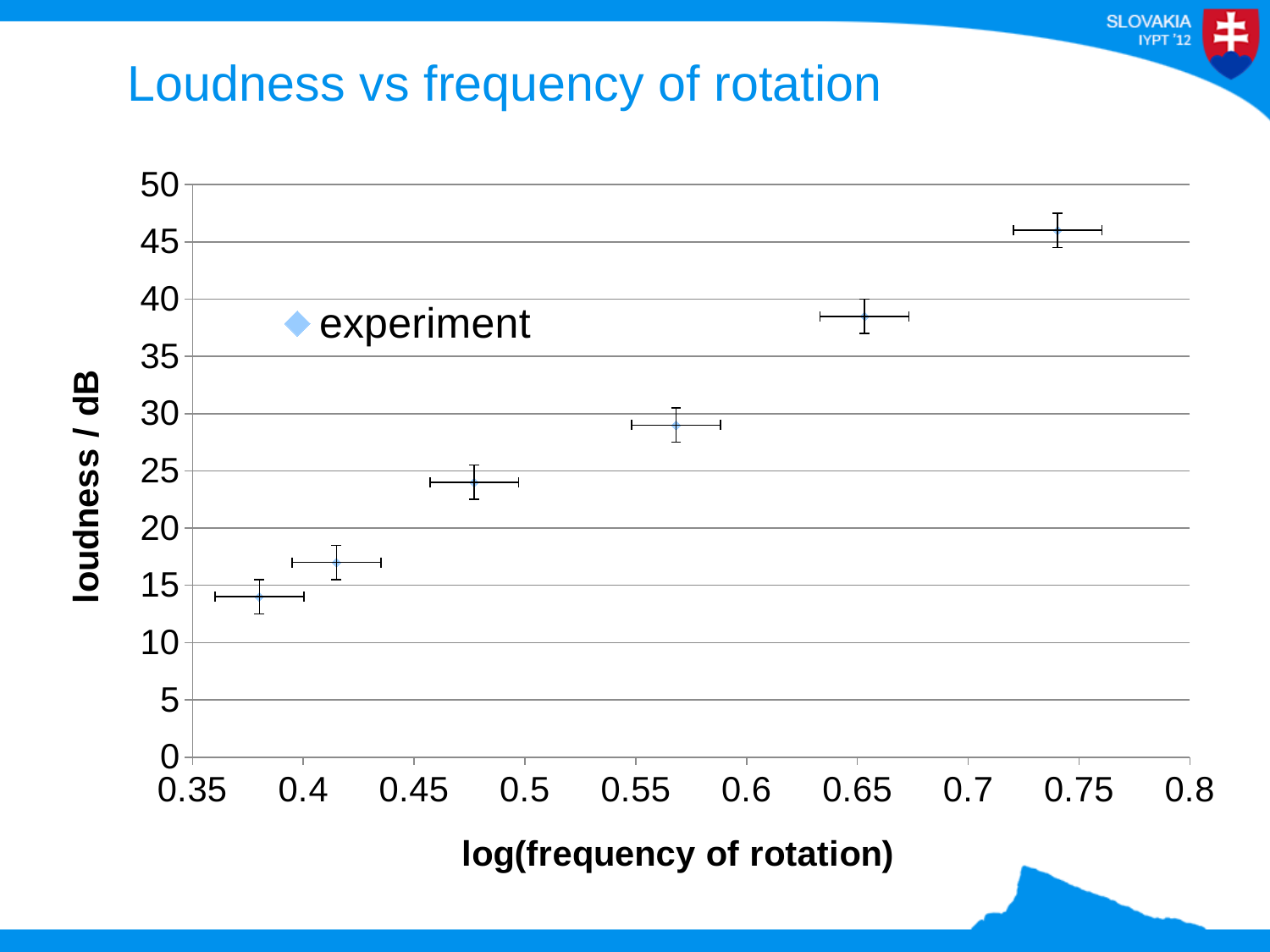
Which data point has the highest loudness: the one near log(frequency) 0.74 or the one near 0.38? the one near 0.74 Do the loudness values rise or fall as log(frequency of rotation) increases? rise How many series does the legend list? 1 What is the label of the y axis? loudness / dB Is the loudness of the rightmost data point (near log(frequency) 0.74) greater or less than 40 dB? greater Is the loudness of the data point near log(frequency) 0.48 greater or less than 20 dB? greater How many data points are plotted in the chart? 6 Is the loudness of the leftmost data point (near log(frequency) 0.38) greater or less than 20 dB? less What kind of chart is shown on the slide? scatter chart What is the name of the series shown in the legend? experiment